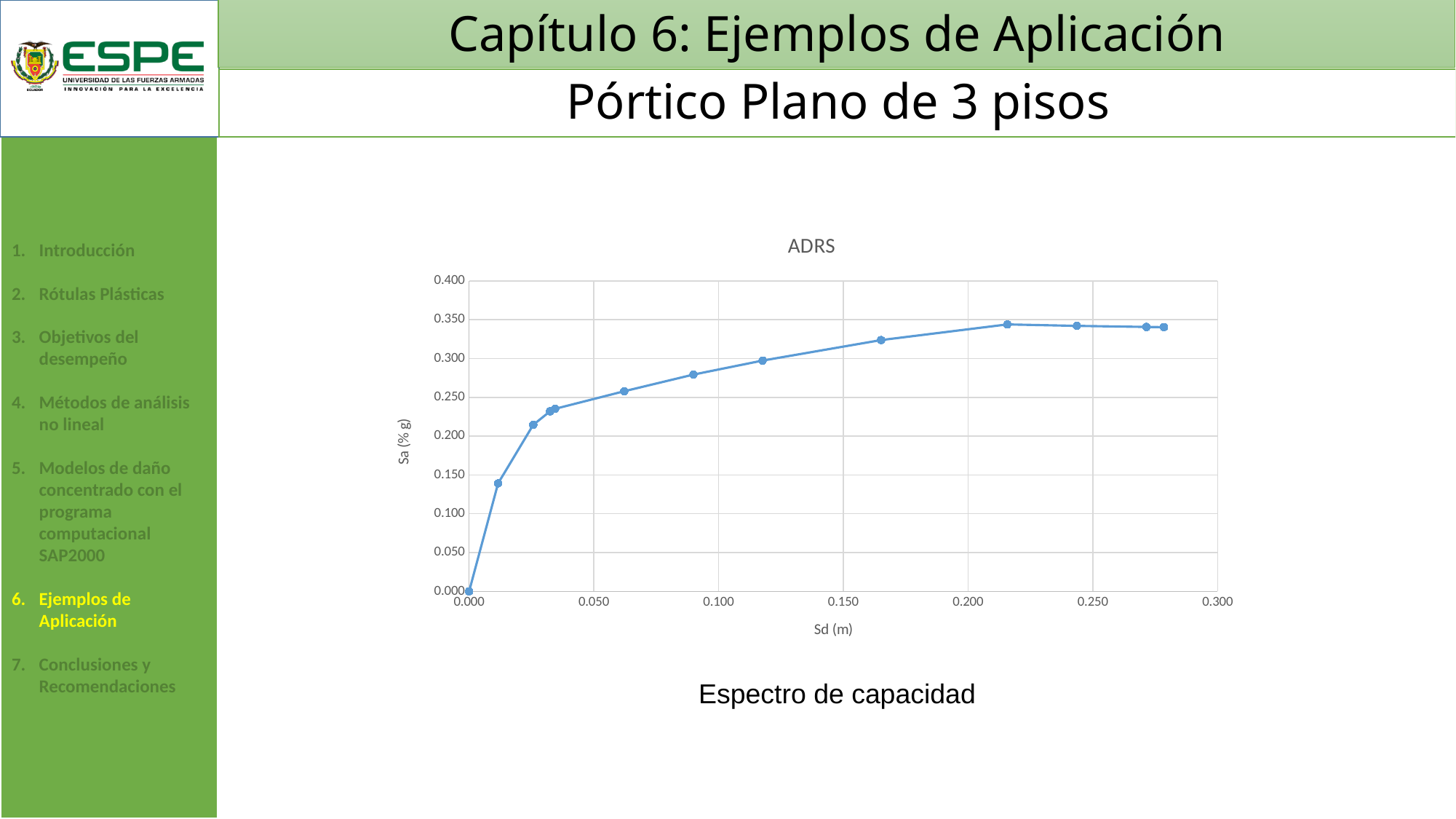
What is the title of the chart? ADRS Is the Sa value of the point near Sd = 0.011 greater or less than 0.200? less What is the Sa value of the first point, at Sd = 0.000? 0.000 Do the Sa values generally rise or fall as Sd increases from 0.000 to 0.200? rise Which point has the lowest Sa value on the chart? the point at Sd = 0.000 Is the Sa value of the point near Sd = 0.090 greater or less than 0.250? greater Is the Sa value of the point near Sd = 0.062 greater or less than 0.200? greater Which has the larger Sa value: the point near Sd = 0.026 or the point near Sd = 0.118? the point near Sd = 0.118 What is the label of the x axis of the chart? Sd (m) What kind of chart is shown on the slide? line chart